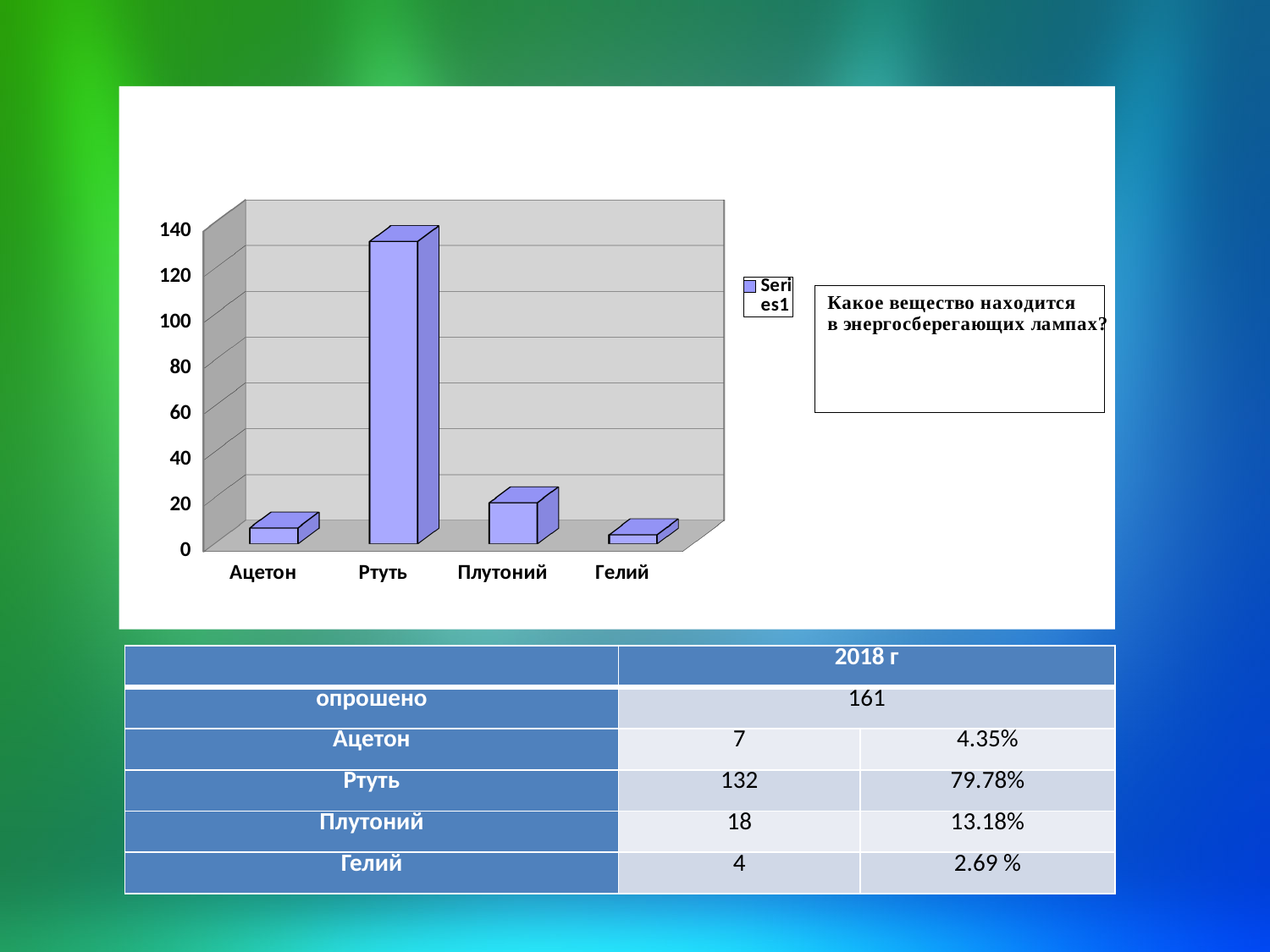
Is the value for Ртуть greater or less than 120? greater According to the table below the chart, what is the value for Ртуть? 132 Is the value for Ацетон greater or less than 20? less According to the table below the chart, what is the difference between the values for Ртуть and Плутоний? 114 Which category has the lowest bar in the chart? Гелий How many categories are shown on the x axis of the chart? 4 Is the value for Плутоний greater or less than 20? less What kind of chart is shown on the slide? bar chart Which category has the highest bar in the chart? Ртуть How many series does the chart legend list? 1 Which is larger, the bar for Плутоний or the bar for Ацетон? Плутоний What is the name of the series shown in the chart legend? Series1